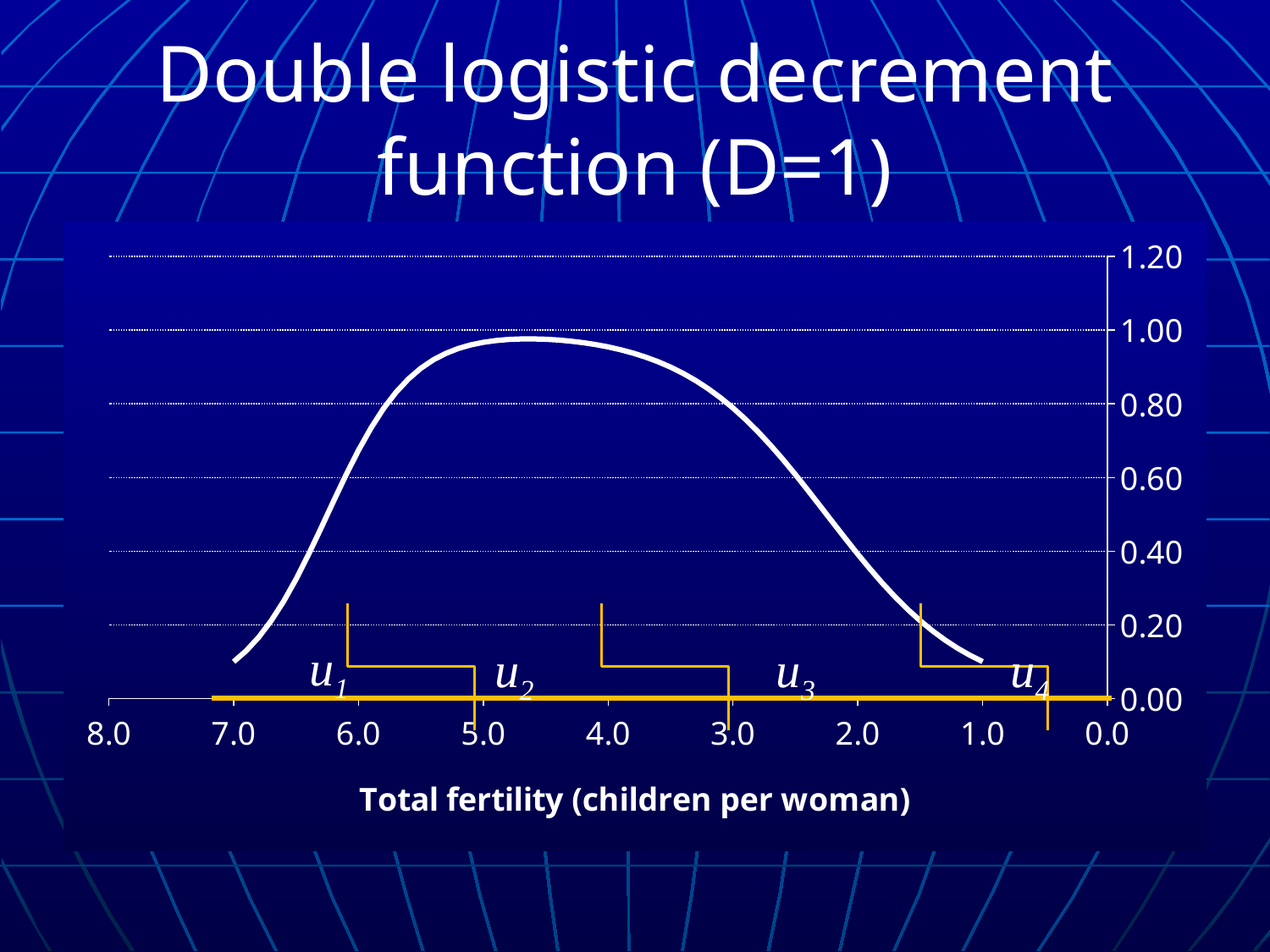
What is the title of the chart on the slide? Double logistic decrement function (D=1) Is the value of the curve at a total fertility of 5.0 greater or less than 0.80? greater How many u-labelled intervals (u1 to u4) are marked along the x axis? 4 Is the value of the curve at a total fertility of 7.0 greater or less than 0.20? less What is the label of the x axis? Total fertility (children per woman) What is the highest value shown on the y axis? 1.20 Is the value of the curve at a total fertility of 1.0 greater or less than 0.20? less Does the curve rise or fall as total fertility goes from 4.0 down to 1.0? fall Which is larger, the value of the curve at a total fertility of 5.0 or at 2.0? 5.0 What kind of chart is shown on the slide? line chart